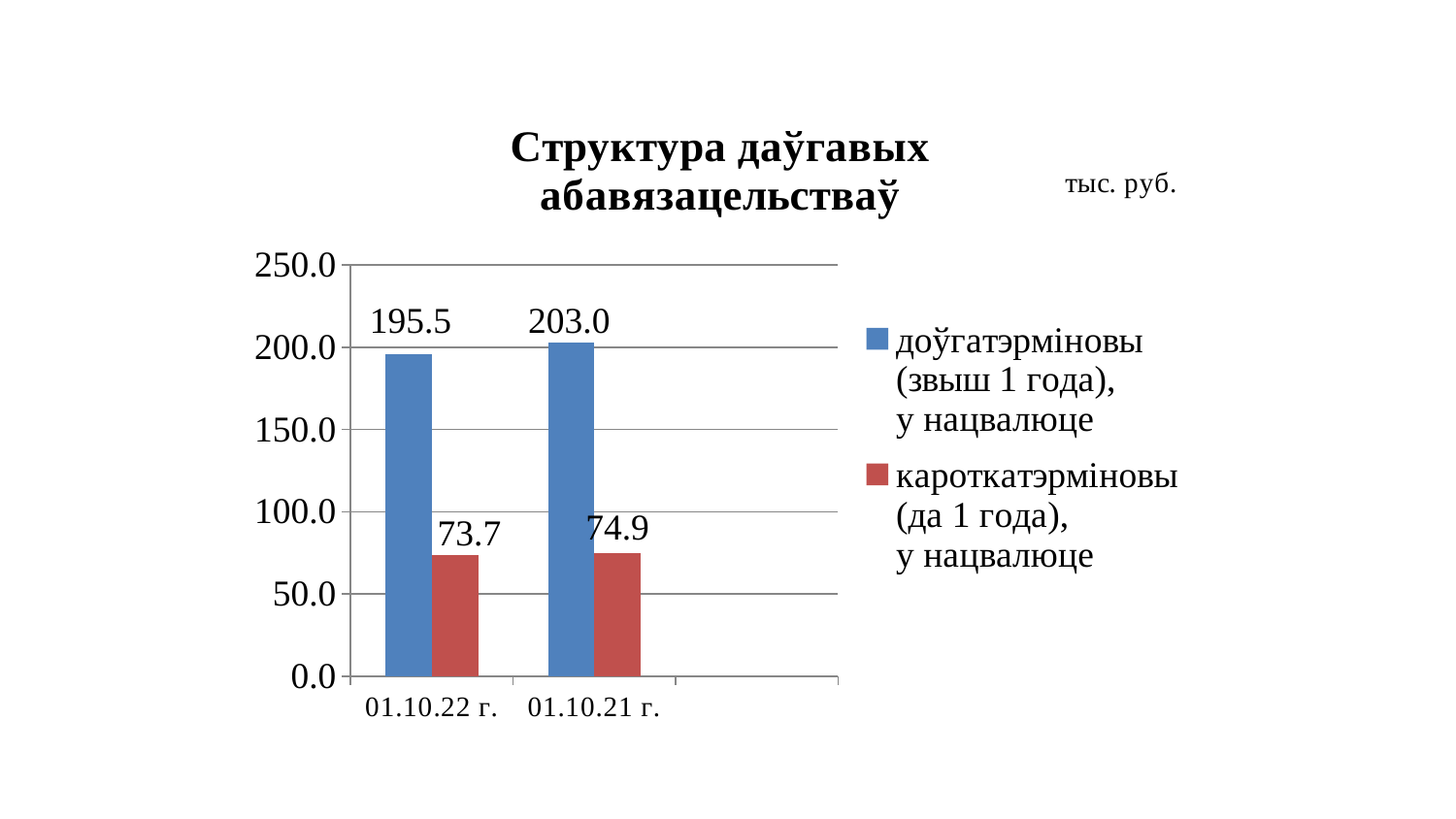
Is the long-term value for 01.10.21 г. greater or less than 200.0? greater How many date categories are shown on the x axis? 2 What is the value of the short-term (кароткатэрміновы) series for 01.10.22 г.? 73.7 What is the value of the long-term (доўгатэрміновы) series for 01.10.22 г.? 195.5 What is the difference between the short-term values for 01.10.21 г. and 01.10.22 г.? 1.2 What is the value of the long-term (доўгатэрміновы) series for 01.10.21 г.? 203.0 What is the value of the short-term (кароткатэрміновы) series for 01.10.21 г.? 74.9 Which is larger: the long-term value for 01.10.22 г. or the short-term value for 01.10.22 г.? the long-term value (195.5) What is the difference between the long-term values for 01.10.21 г. and 01.10.22 г.? 7.5 Which date has the higher long-term (доўгатэрміновы) value? 01.10.21 г. How many series does the legend list? 2 What type of chart is shown on the slide? bar chart